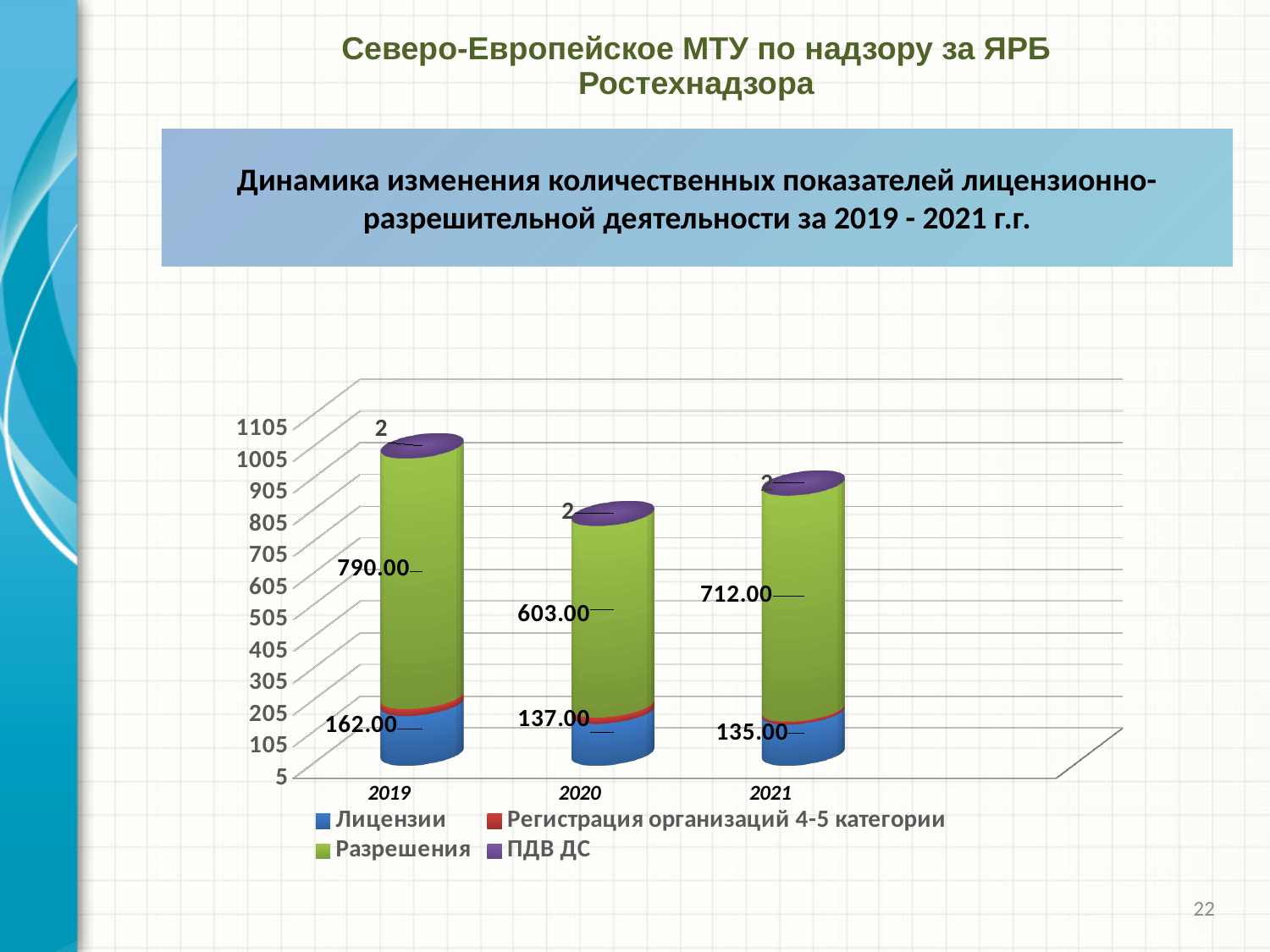
What is the value for ПДВ ДС in 2020? 2 Which is larger, the Лицензии value for 2019 or for 2020? 2019 In which year is the value for Разрешения highest? 2019 What is the value for Разрешения in 2021? 712.00 What is the difference between the Разрешения values for 2019 and 2020? 187.00 How many years are shown on the x axis? 3 How many series does the legend list? 4 What is the value for Разрешения in 2020? 603.00 In which year is the value for Лицензии lowest? 2021 What is the value for Лицензии in 2021? 135.00 What is the value for Лицензии in 2019? 162.00 What kind of chart is shown on the slide? Stacked bar chart